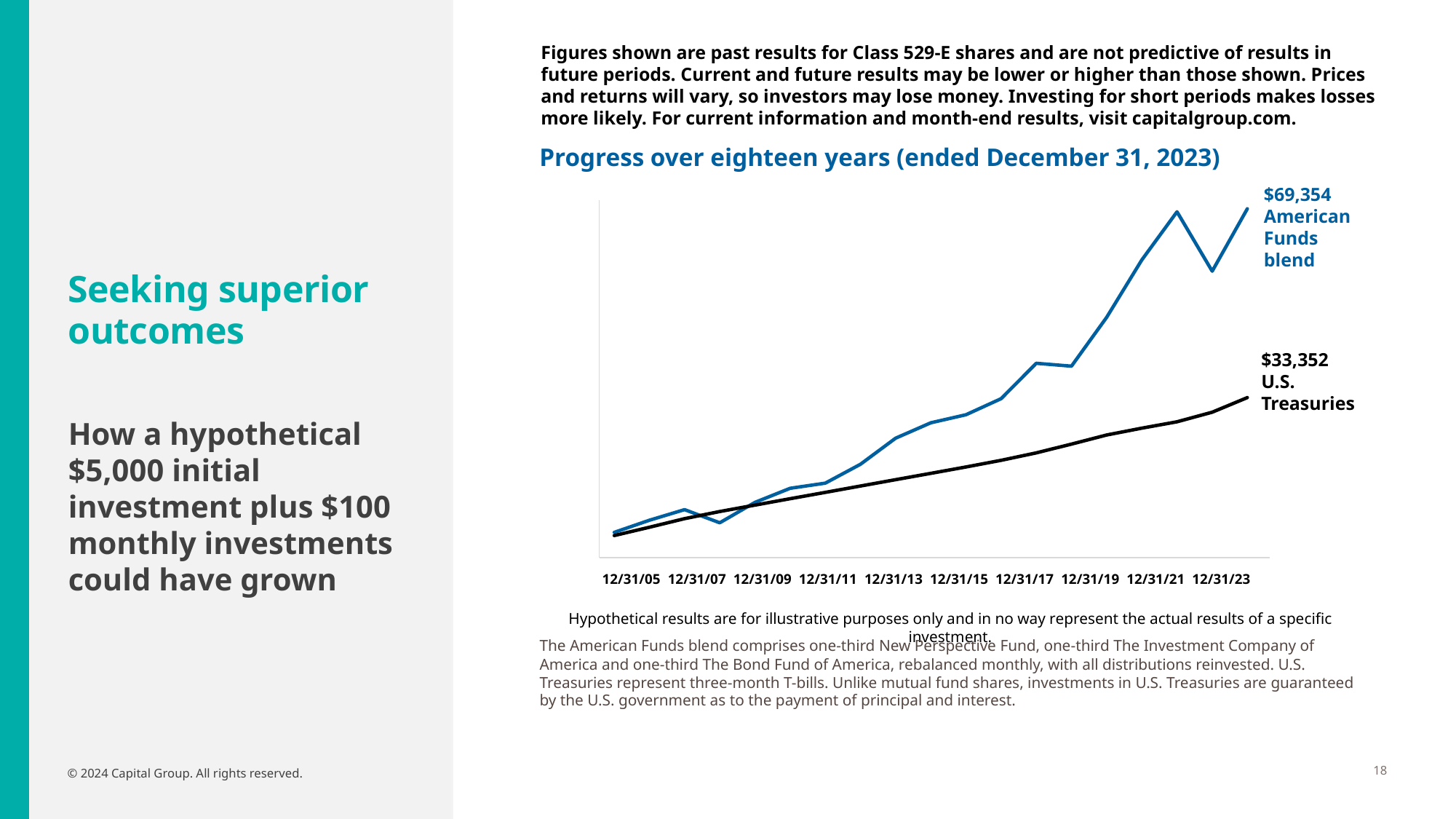
Which series ends at a higher value, the American Funds blend or U.S. Treasuries? American Funds blend What colour is the line for the American Funds blend? Blue What is the title of the chart? Progress over eighteen years (ended December 31, 2023) How many date labels are shown along the x axis? 10 What is the difference between the ending value of the American Funds blend and the ending value of U.S. Treasuries? $36,002 What is the ending value shown for the American Funds blend? $69,354 What is the first date label on the x axis? 12/31/05 How many series are plotted on the chart? 2 Overall, does the American Funds blend line rise or fall from 12/31/05 to 12/31/23? Rises What is the ending value shown for U.S. Treasuries? $33,352 What kind of chart is shown on the slide? Line chart Does the U.S. Treasuries line rise or fall from 12/31/05 to 12/31/23? Rises